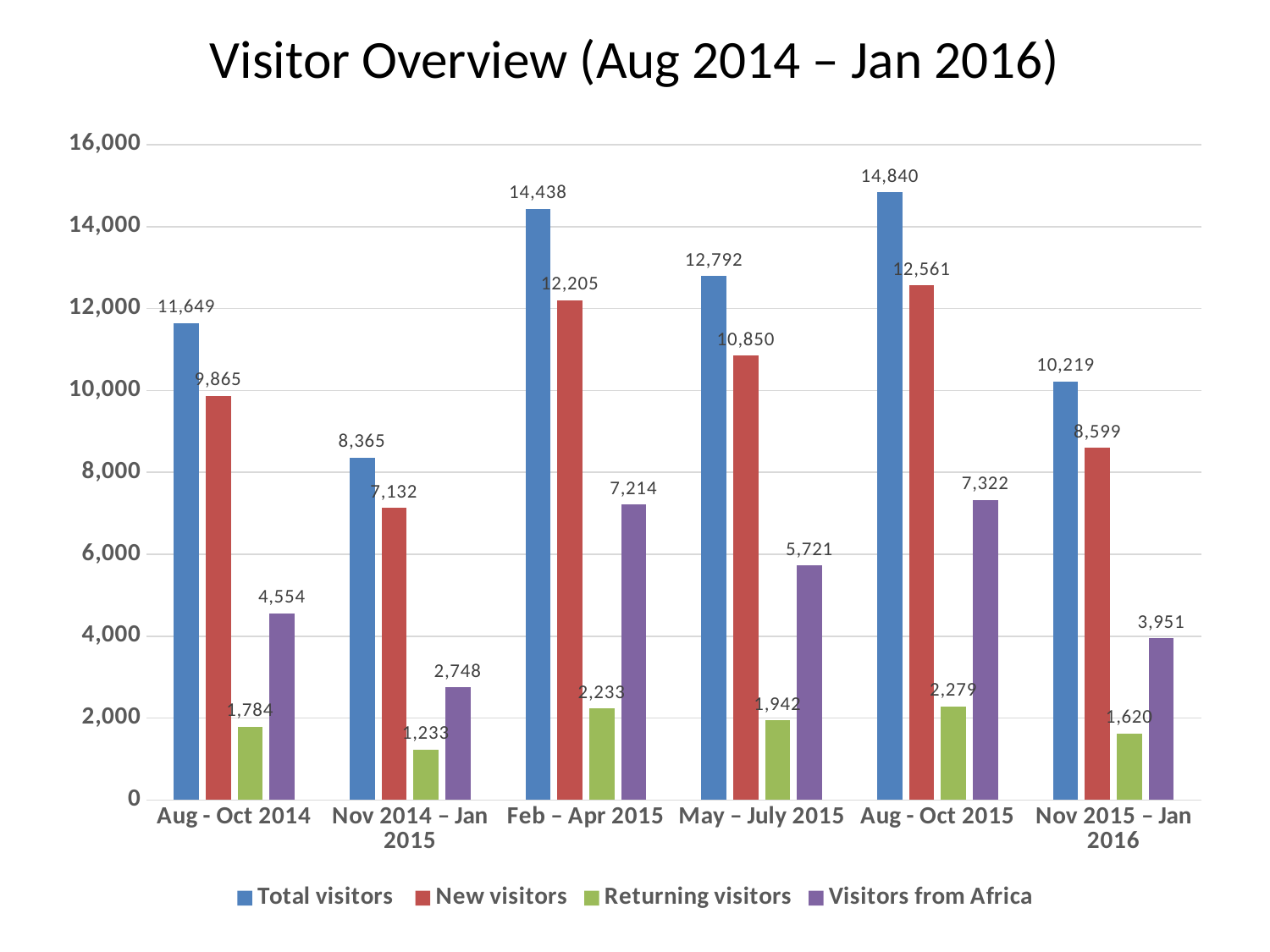
What is the title of the chart? Visitor Overview (Aug 2014 – Jan 2016) What is the value for Visitors from Africa in Feb – Apr 2015? 7,214 What is the value for New visitors in Nov 2014 – Jan 2015? 7,132 Which period has the highest value for Total visitors? Aug - Oct 2015 What is the difference between Total visitors and New visitors in Feb – Apr 2015? 2,233 What kind of chart is shown on the slide? Bar chart Which period has the lowest value for Returning visitors? Nov 2014 – Jan 2015 What is the value for Returning visitors in Nov 2015 – Jan 2016? 1,620 How many periods are shown on the x axis? 6 Which is larger: Visitors from Africa in Aug - Oct 2015 or Visitors from Africa in May – July 2015? Aug - Oct 2015 How many series does the legend list? 4 What is the value for Total visitors in Aug - Oct 2015? 14,840